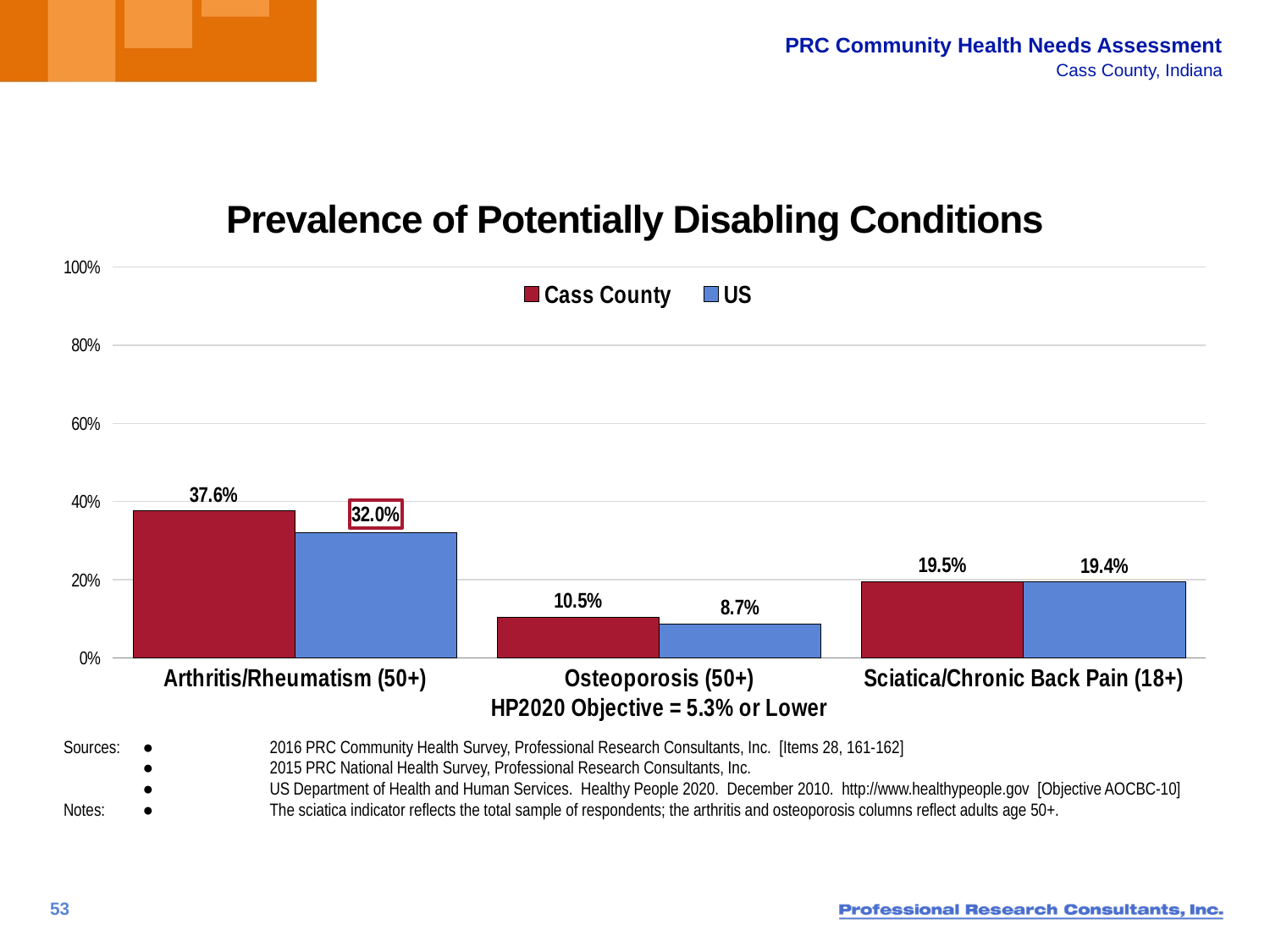
How many conditions are shown on the x axis? 3 What is the difference between the Cass County and US values for Arthritis/Rheumatism (50+)? 5.6% What is the Cass County value for Arthritis/Rheumatism (50+)? 37.6% Which is larger for Osteoporosis (50+): the Cass County value or the US value? Cass County How many series does the legend list? 2 What kind of chart is shown on the slide? Bar chart What is the US value for Arthritis/Rheumatism (50+)? 32.0% Which condition has the highest Cass County value? Arthritis/Rheumatism (50+) Which condition has the lowest US value? Osteoporosis (50+) What is the US value for Osteoporosis (50+)? 8.7% What is the difference between the Cass County and US values for Osteoporosis (50+)? 1.8% What is the Cass County value for Sciatica/Chronic Back Pain (18+)? 19.5%